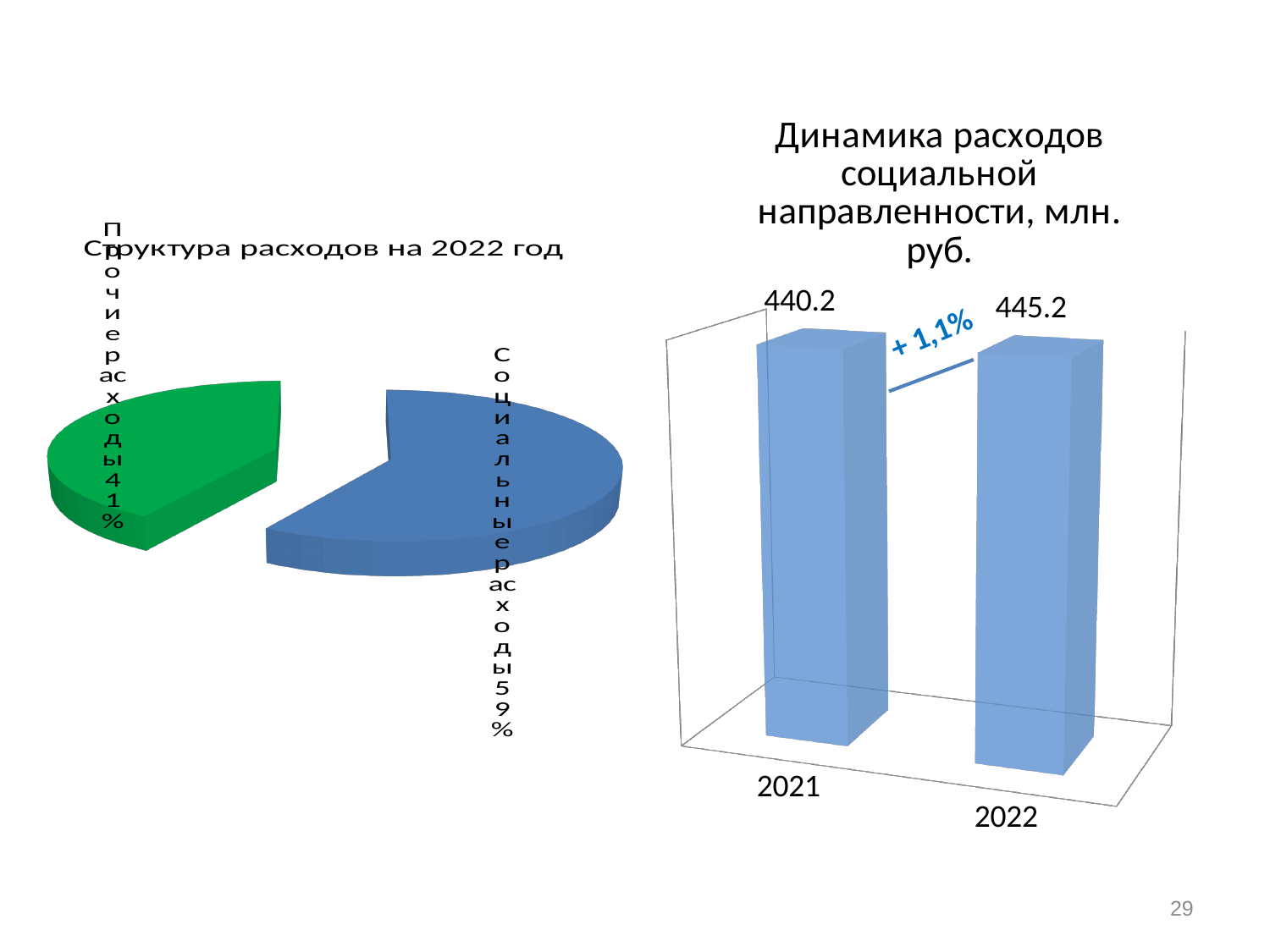
In the chart 'Динамика расходов социальной направленности, млн. руб.', what percentage change is annotated between 2021 and 2022? + 1,1% In the chart 'Динамика расходов социальной направленности, млн. руб.', what is the value for 2022? 445.2 How many slices does the pie chart 'Структура расходов на 2022 год' have? 2 In the chart 'Динамика расходов социальной направленности, млн. руб.', what is the value for 2021? 440.2 What kind of chart is 'Структура расходов на 2022 год'? Pie chart In the chart 'Структура расходов на 2022 год', what share do 'Прочие расходы' have? 41% In the chart 'Структура расходов на 2022 год', what share do 'Социальные расходы' have? 59% What kind of chart is 'Динамика расходов социальной направленности, млн. руб.'? Bar chart In the chart 'Структура расходов на 2022 год', what colour is the 'Прочие расходы' slice? Green In the chart 'Динамика расходов социальной направленности, млн. руб.', what is the difference between the 2022 and 2021 values? 5.0 In the chart 'Структура расходов на 2022 год', which slice is larger: 'Социальные расходы' or 'Прочие расходы'? Социальные расходы In the chart 'Динамика расходов социальной направленности, млн. руб.', which year has the higher value? 2022